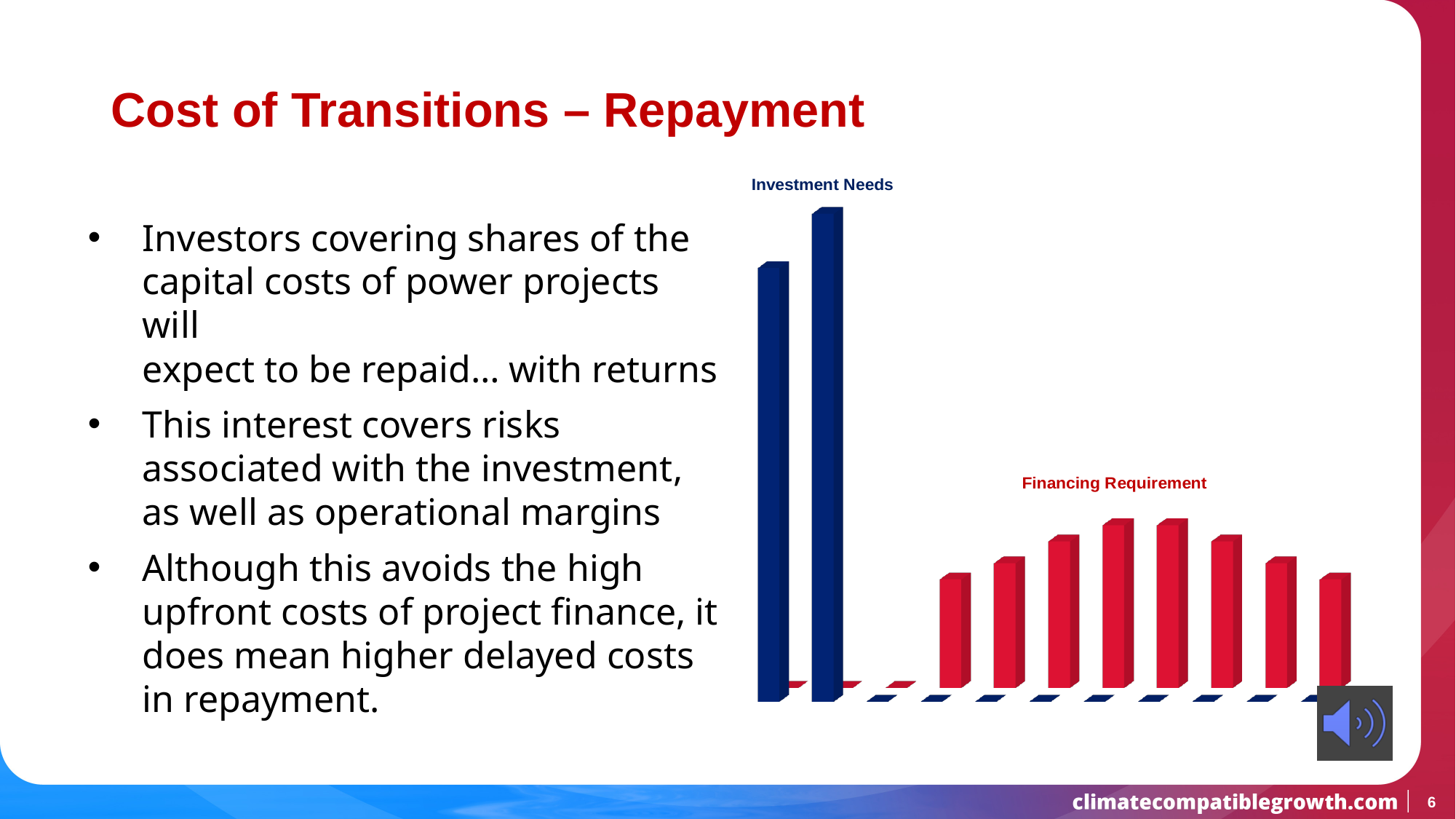
What kind of chart is shown on the slide? bar chart Do the Financing Requirement bars rise or fall over the first four bars from the left? rise How many Financing Requirement bars are shown? 8 Which of the two Investment Needs bars is taller, the first or the second? the second What are the two series labelled on the chart? Investment Needs and Financing Requirement How many Investment Needs bars are shown? 2 What colour are the Investment Needs bars? dark blue Which Financing Requirement bar is the tallest, counting from the left? the fourth and fifth (tied) Do the Financing Requirement bars rise or fall over the last four bars on the right? fall How many series are labelled on the chart? 2 Are the Investment Needs bars taller or shorter than the Financing Requirement bars? taller Which Financing Requirement bar is the shortest, counting from the left? the first and the eighth (tied)